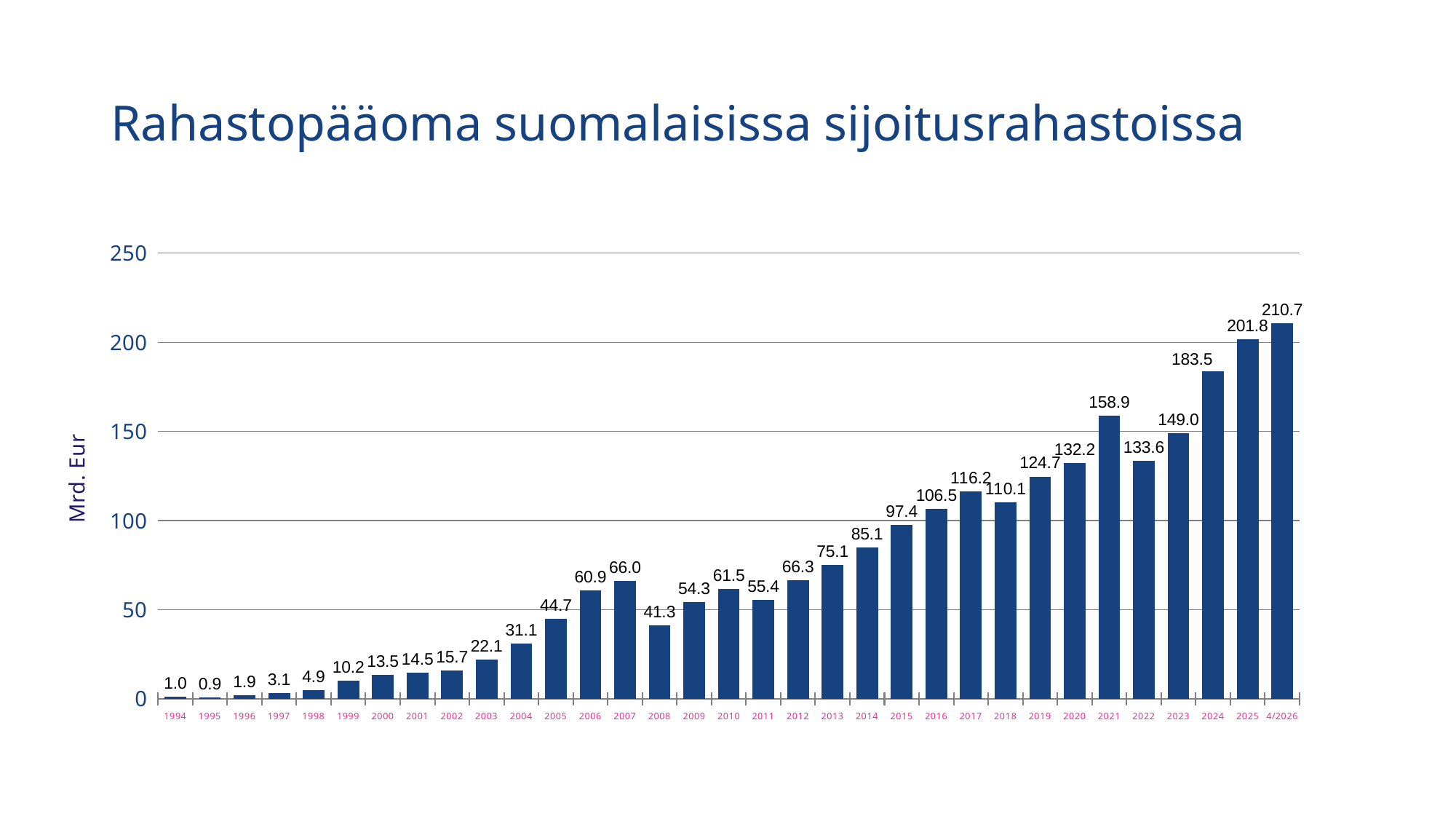
How many bars are shown in the chart? 33 What is the value for 4/2026? 210.7 Which year has the highest value? 4/2026 What kind of chart is shown on the slide? bar chart Which is larger, the value for 2007 or the value for 2012? 2012 Do the values generally rise or fall from 1994 to 4/2026? rise What is the label on the vertical axis? Mrd. Eur Is the value for 2022 greater or less than 150? less Which year has the lowest value? 1995 What is the difference between the values for 2025 and 2024? 18.3 What is the value for 2008? 41.3 What is the value for 2021? 158.9